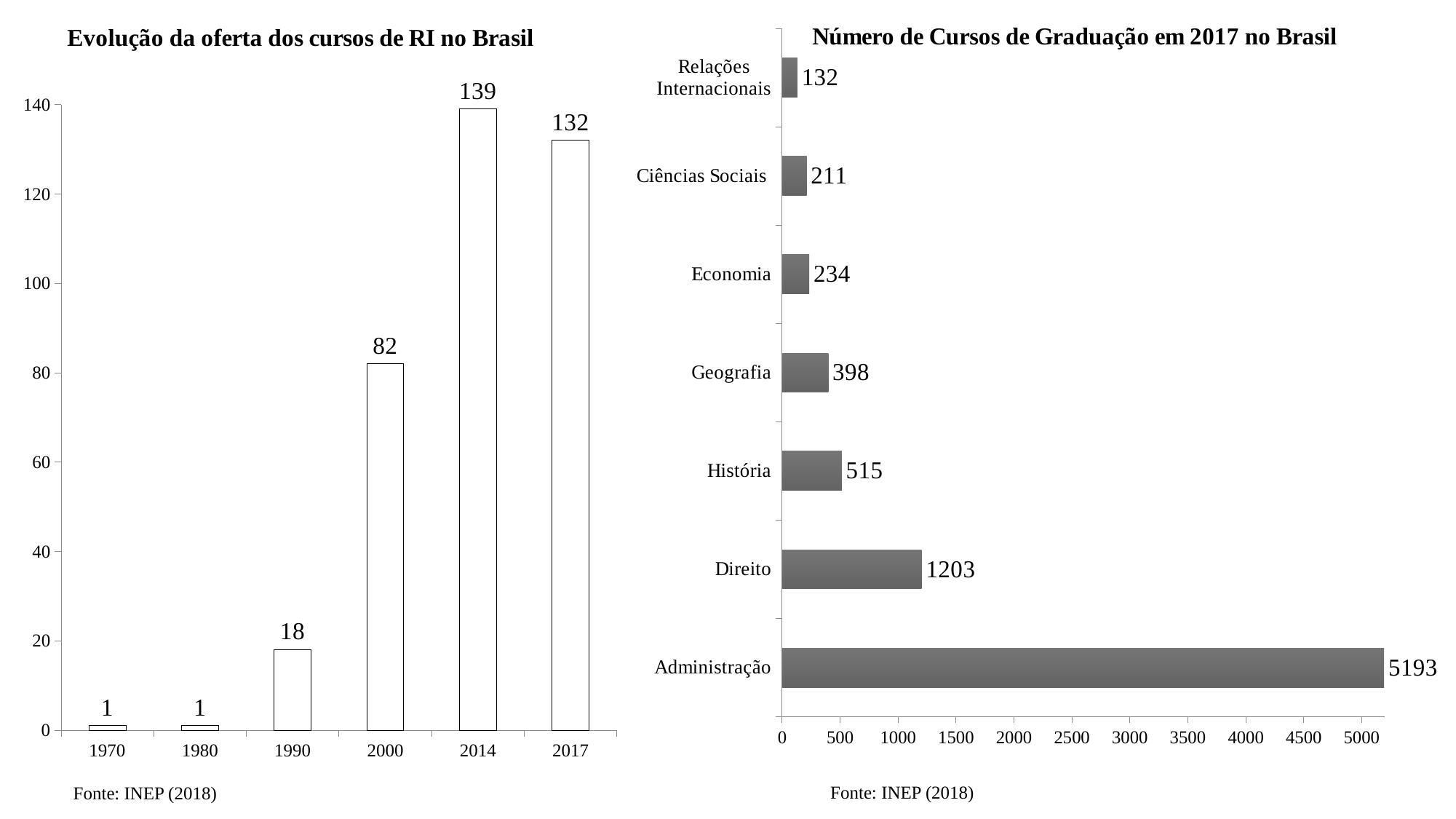
In the chart 'Evolução da oferta dos cursos de RI no Brasil', what is the value for 2000? 82 In the chart 'Número de Cursos de Graduação em 2017 no Brasil', what is the value for Direito? 1203 In the chart 'Evolução da oferta dos cursos de RI no Brasil', do the values rise or fall from 1970 to 2014? rise In the chart 'Número de Cursos de Graduação em 2017 no Brasil', which category has the lowest value? Relações Internacionais In the chart 'Evolução da oferta dos cursos de RI no Brasil', how many years are shown on the x axis? 6 In the chart 'Número de Cursos de Graduação em 2017 no Brasil', which category has the highest value? Administração In the chart 'Evolução da oferta dos cursos de RI no Brasil', which year has the highest value? 2014 In the chart 'Número de Cursos de Graduação em 2017 no Brasil', what is the difference between Economia and Ciências Sociais? 23 In the chart 'Evolução da oferta dos cursos de RI no Brasil', what is the value for 1990? 18 What kind of chart is 'Número de Cursos de Graduação em 2017 no Brasil'? bar chart In the chart 'Número de Cursos de Graduação em 2017 no Brasil', which is larger, História or Geografia? História In the chart 'Evolução da oferta dos cursos de RI no Brasil', what is the difference between the values for 2014 and 2017? 7